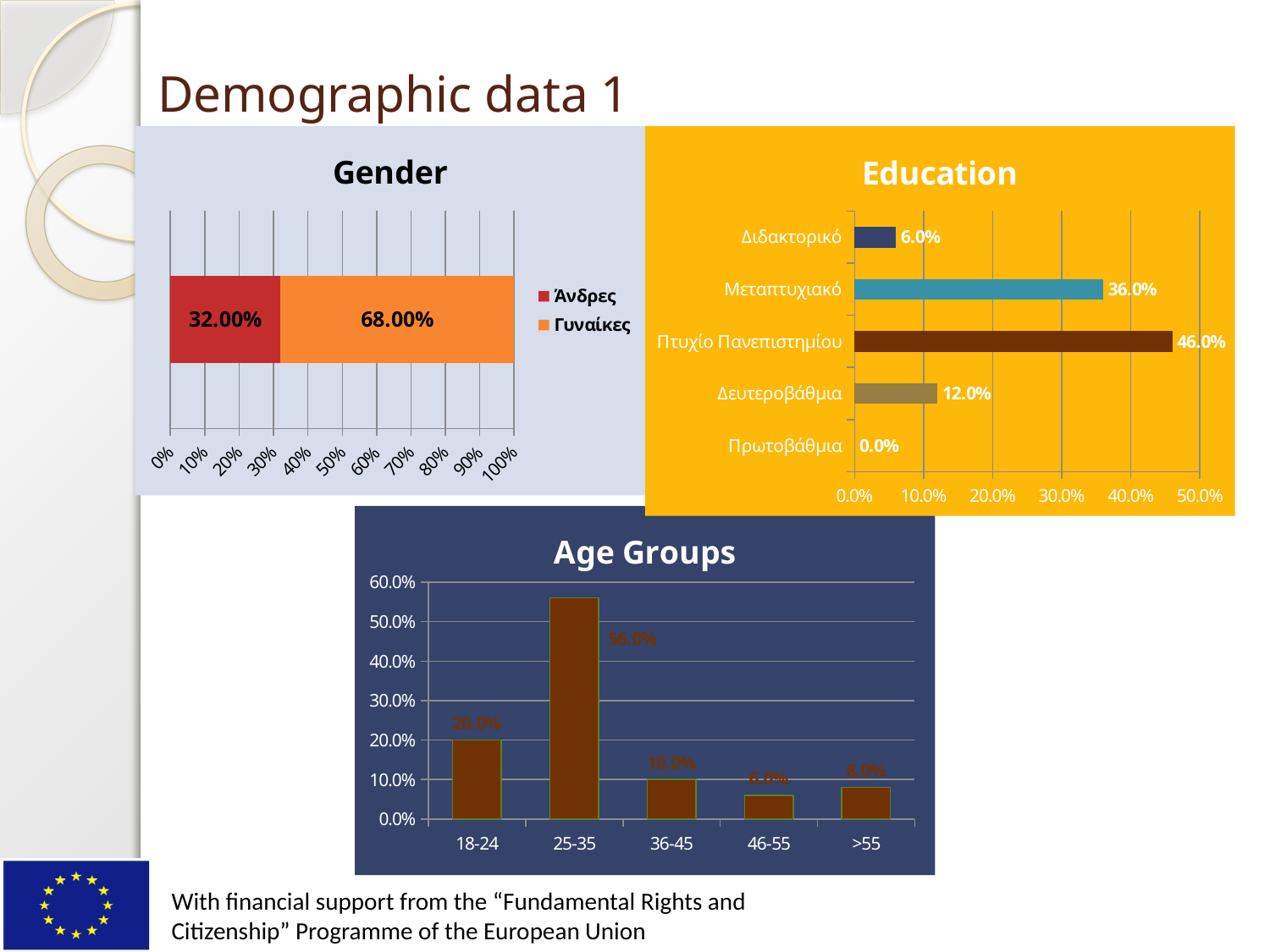
In the Age Groups chart, which is larger, 18-24 or 36-45? 18-24 In the Education chart, what is the value for Μεταπτυχιακό? 36.0% How many categories are shown in the Education chart? 5 In the Gender chart, what is the value for Γυναίκες? 68.00% In the Gender chart, what is the value for Άνδρες? 32.00% In the Education chart, which category has the highest value? Πτυχίο Πανεπιστημίου What kind of chart is the Age Groups chart? Bar chart In the Age Groups chart, what is the value for 25-35? 56.0% In the Education chart, what is the difference between Πτυχίο Πανεπιστημίου and Δευτεροβάθμια? 34.0% In the Education chart, which category has the lowest value? Πρωτοβάθμια In the Age Groups chart, which age group has the lowest value? 46-55 How many series does the legend of the Gender chart list? 2